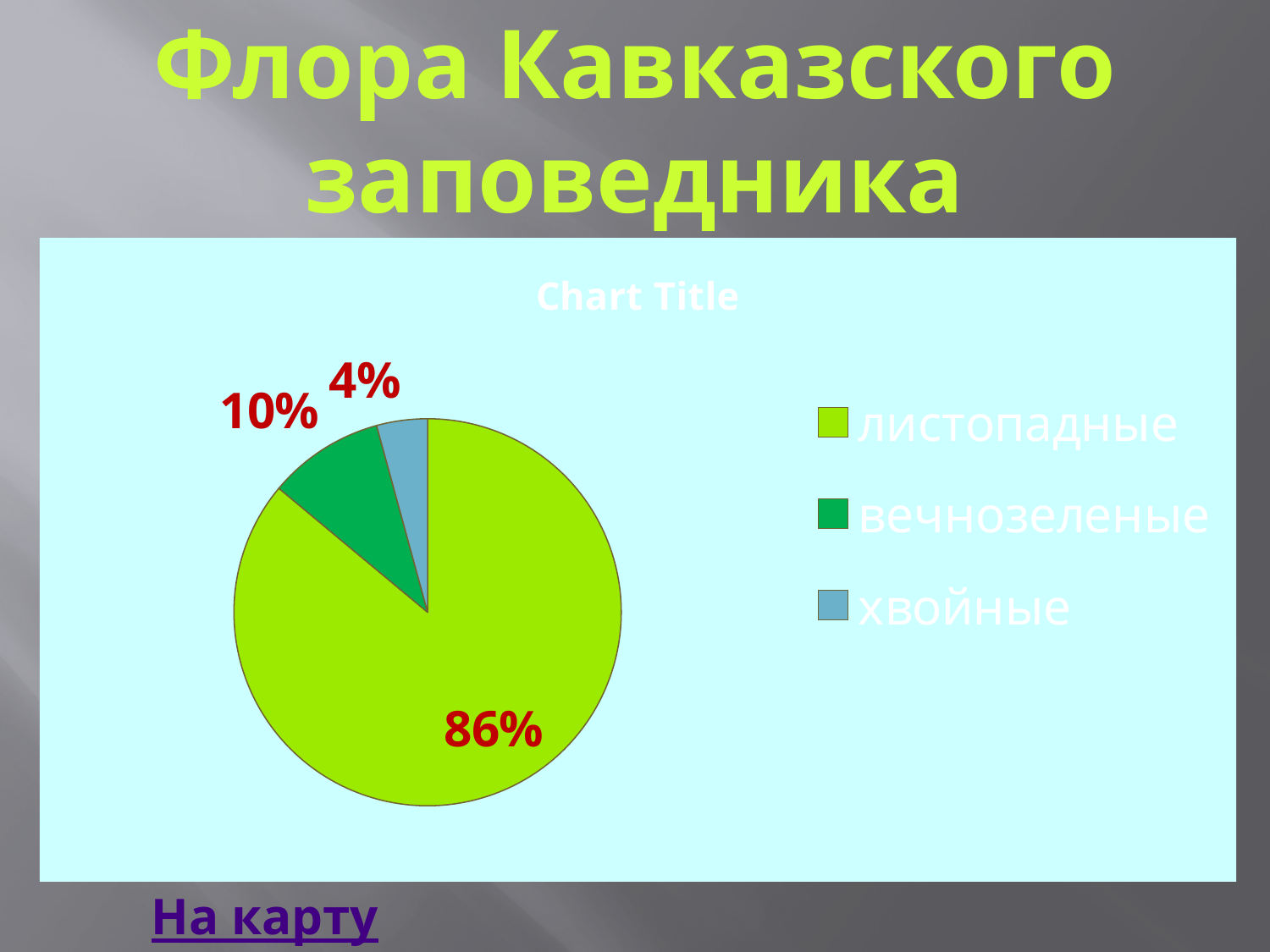
What kind of chart is shown on the slide? pie chart What is the difference in percentage points between листопадные and вечнозеленые? 76 Which category has the largest slice of the pie? листопадные What colour is the slice for хвойные? light blue Which is larger, the share for вечнозеленые or the share for хвойные? вечнозеленые How many categories does the pie chart show? 3 What is the title shown above the pie chart? Chart Title What is the difference in percentage points between вечнозеленые and хвойные? 6 What share of the pie does листопадные have? 86% Which category has the smallest slice of the pie? хвойные What share of the pie does хвойные have? 4% What share of the pie does вечнозеленые have? 10%